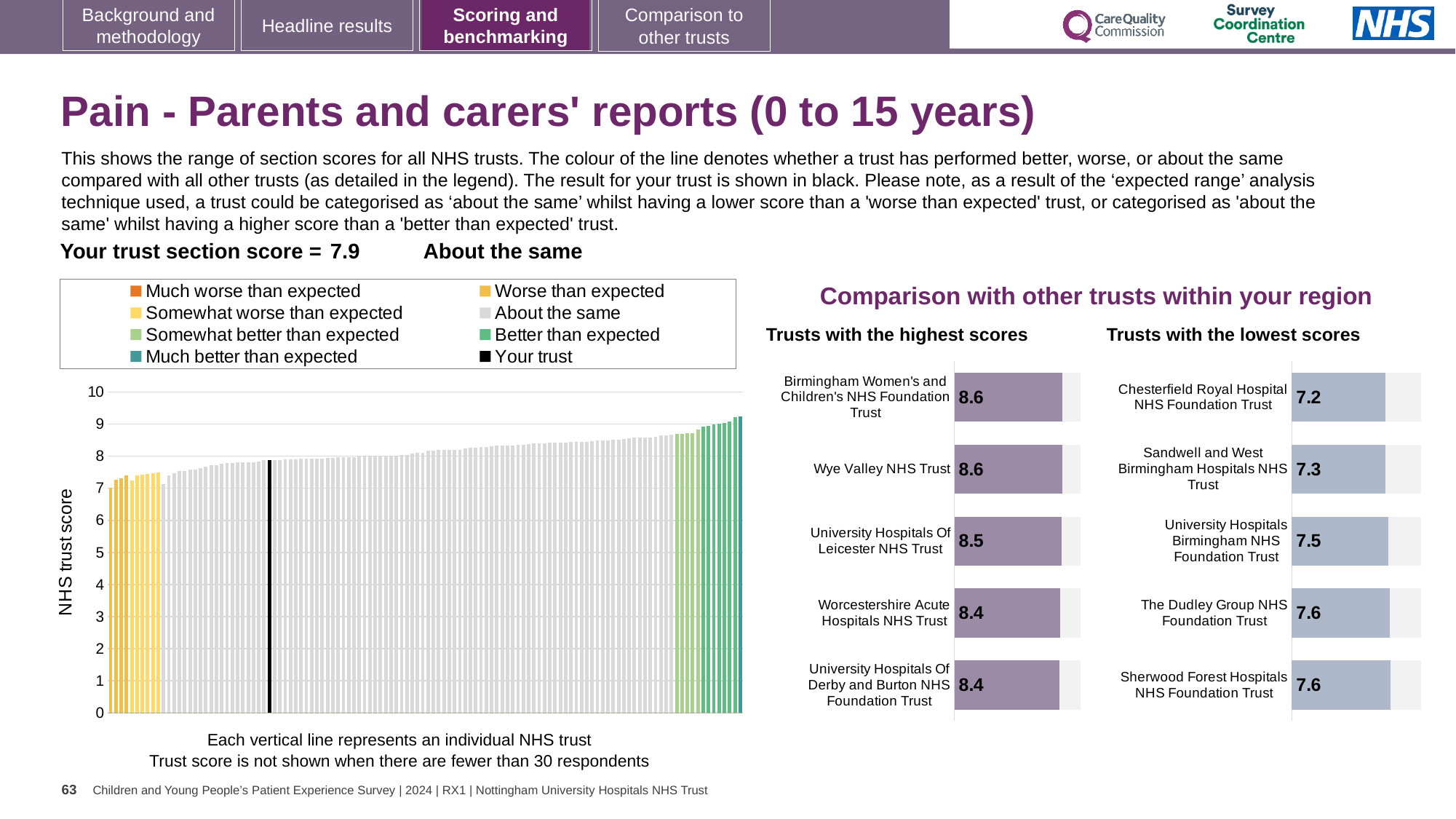
In the 'Trusts with the lowest scores' chart, which has the larger score: Sandwell and West Birmingham Hospitals NHS Trust or University Hospitals Birmingham NHS Foundation Trust? University Hospitals Birmingham NHS Foundation Trust In the 'Trusts with the lowest scores' chart, which trust has the lowest score? Chesterfield Royal Hospital NHS Foundation Trust What is the y-axis label of the large chart on the left? NHS trust score In the 'Trusts with the lowest scores' chart, what is the score for Sandwell and West Birmingham Hospitals NHS Trust? 7.3 What kind of chart is the large chart on the left showing NHS trust scores? Bar chart In the 'Trusts with the lowest scores' chart, what is the difference between the scores of The Dudley Group NHS Foundation Trust and Chesterfield Royal Hospital NHS Foundation Trust? 0.4 How many entries does the legend of the large chart on the left list? 8 In the 'Trusts with the highest scores' chart, what is the difference between the scores of Birmingham Women's and Children's NHS Foundation Trust and University Hospitals Of Derby and Burton NHS Foundation Trust? 0.2 In the large chart on the left, is the value for your trust (the black bar) greater or less than 5? greater How many trusts are shown in the 'Trusts with the highest scores' chart? 5 In the 'Trusts with the highest scores' chart, what is the score for Wye Valley NHS Trust? 8.6 In the 'Trusts with the highest scores' chart, what is the score for University Hospitals Of Leicester NHS Trust? 8.5